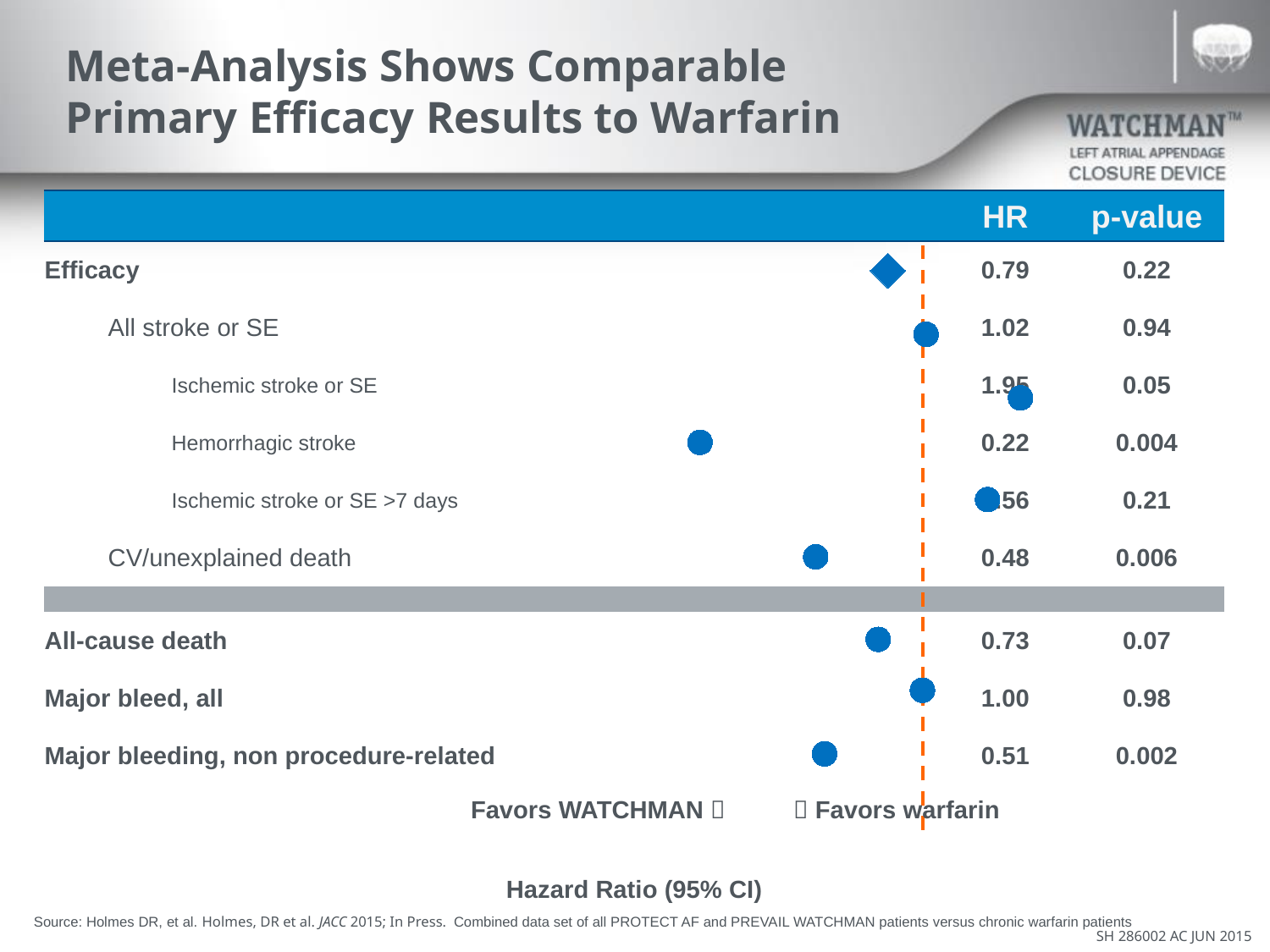
What is the difference between the HR for Efficacy and the HR for All-cause death? 0.06 What kind of chart is shown on the slide? Forest plot (dot plot of hazard ratios) Which outcome has the lowest hazard ratio? Hemorrhagic stroke Which has the larger HR: Major bleed, all or Major bleeding, non procedure-related? Major bleed, all What is the p-value for Hemorrhagic stroke? 0.004 What is the HR for Major bleeding, non procedure-related? 0.51 What is the hazard ratio (HR) for Efficacy? 0.79 What is the HR for CV/unexplained death? 0.48 Which outcome has the highest hazard ratio? Ischemic stroke or SE How many outcomes are plotted in the chart? 9 What is the label of the horizontal axis? Hazard Ratio (95% CI) What is the p-value for All stroke or SE? 0.94